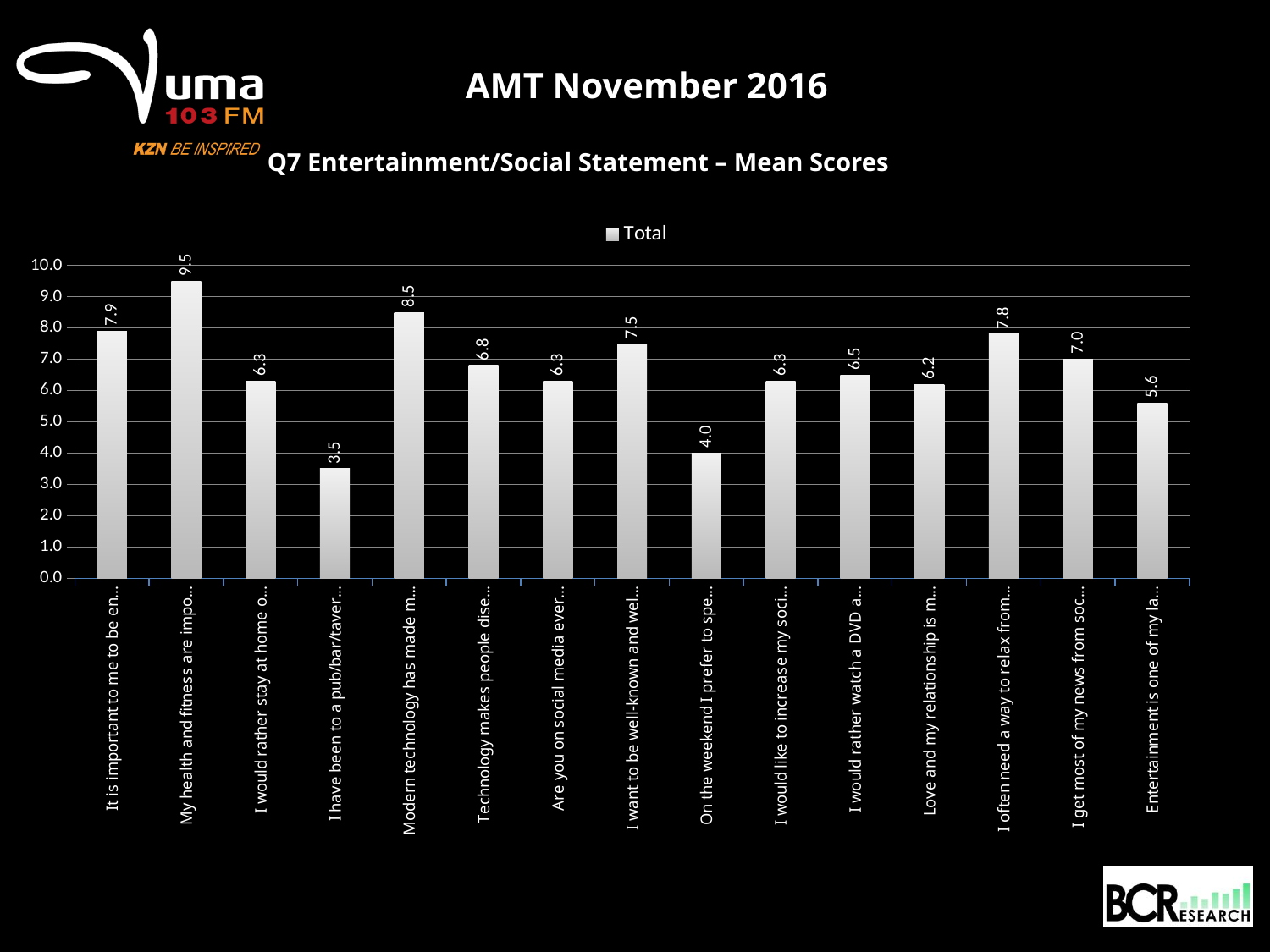
What is the mean score for the statement beginning "Entertainment is one of my la..."? 5.6 What type of chart is shown on the slide? Bar chart What is the mean score for the statement beginning "Modern technology has made m..."? 8.5 Which statement has the highest mean score? My health and fitness are impo... What is the mean score for the statement beginning "I have been to a pub/bar/taver..."? 3.5 How many statements (bars) are shown in the chart? 15 Which has a higher mean score: "I often need a way to relax from..." or "I get most of my news from soc..."? I often need a way to relax from... What is the mean score for the statement beginning "My health and fitness are impo..."? 9.5 Which statement has the lowest mean score? I have been to a pub/bar/taver... What is the name of the series shown in the legend? Total What is the difference between the mean scores for "My health and fitness are impo..." and "I have been to a pub/bar/taver..."? 6.0 How many series does the legend list? 1